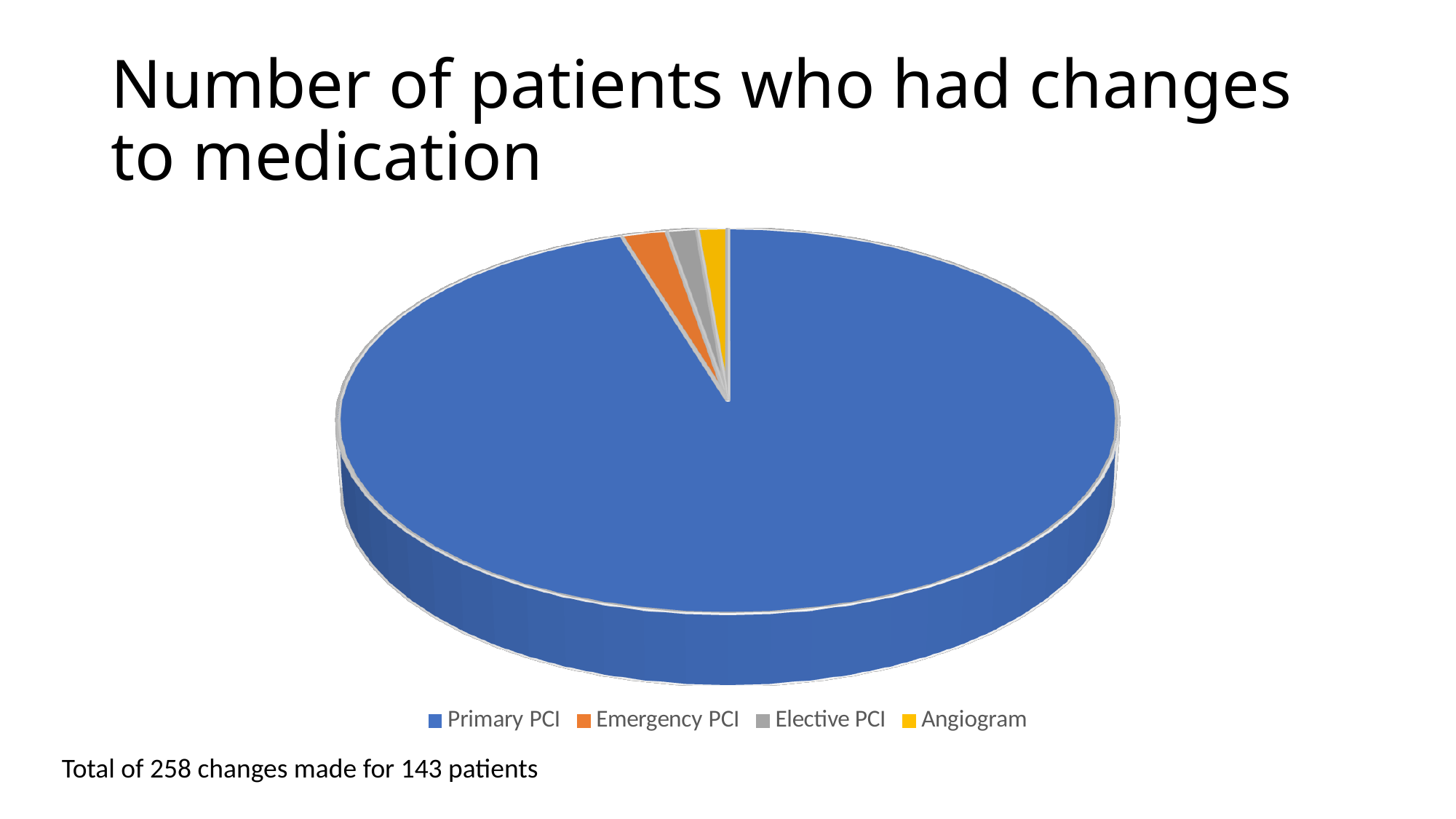
How many categories does the pie chart show? 4 Which is larger in the pie chart, Angiogram or Primary PCI? Primary PCI Which category has the largest slice of the pie chart? Primary PCI Which is larger in the pie chart, Elective PCI or Primary PCI? Primary PCI What kind of chart is shown on the slide? pie chart Which colour represents Angiogram in the pie chart legend? yellow What is the title of the slide containing the pie chart? Number of patients who had changes to medication Which is larger in the pie chart, Primary PCI or Emergency PCI? Primary PCI